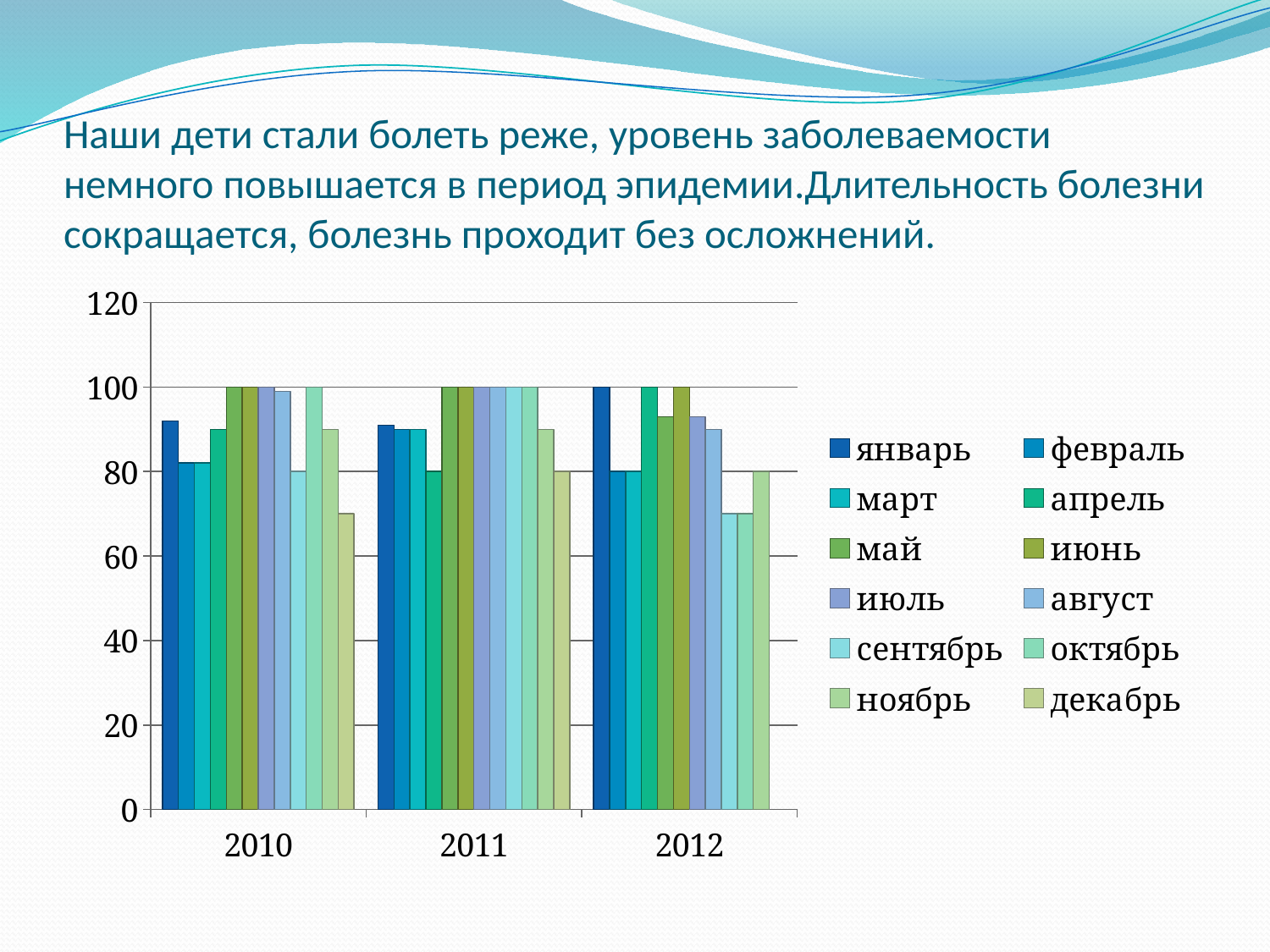
Is the value for сентябрь in 2012 greater or less than 80? less What kind of chart is shown on the slide? bar chart Which is larger, the value for февраль in 2010 or in 2011? 2011 Which is larger, the value for сентябрь in 2011 or in 2012? 2011 Which month has the lowest value in the 2010 group? декабрь Which is larger, the value for декабрь in 2010 or in 2011? 2011 Is the value for декабрь in 2010 greater or less than 80? less Is the value for январь in 2010 greater or less than 80? greater What is the first entry listed in the chart's legend? январь How many series does the chart's legend list? 12 How many year categories are shown on the x axis of the chart? 3